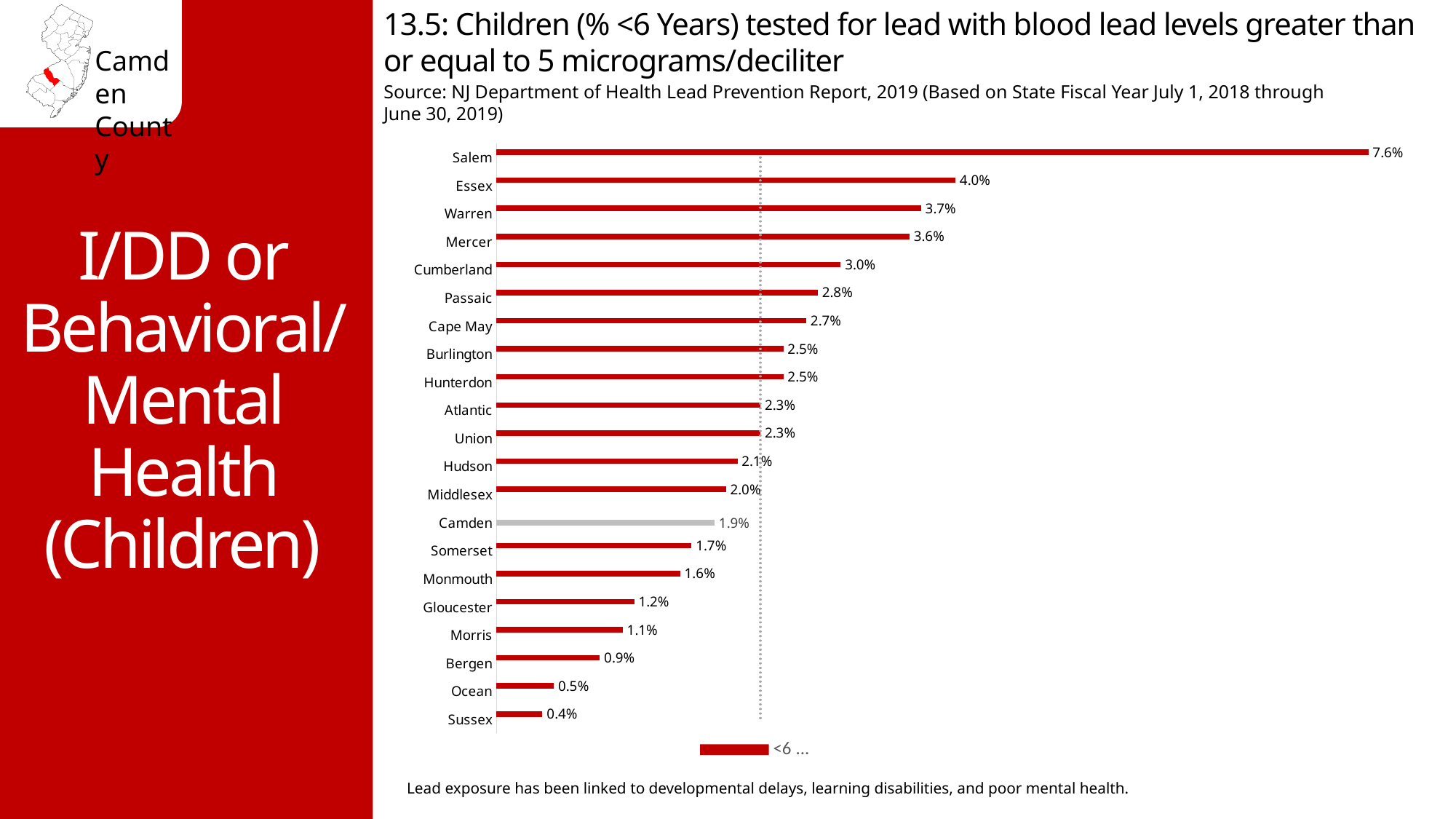
How many counties are shown in the chart? 21 What is the value for Camden? 1.9% Which county has the highest value? Salem What is the difference between the values for Salem and Essex? 3.6% What is the value for Cumberland? 3.0% Which has a larger value, Mercer or Passaic? Mercer What kind of chart is shown on the slide? Bar chart What is the value for Salem? 7.6% Which has a larger value, Bergen or Gloucester? Gloucester What is the difference between the values for Camden and Sussex? 1.5% Which county's bar is shown in grey rather than red? Camden Which county has the lowest value? Sussex